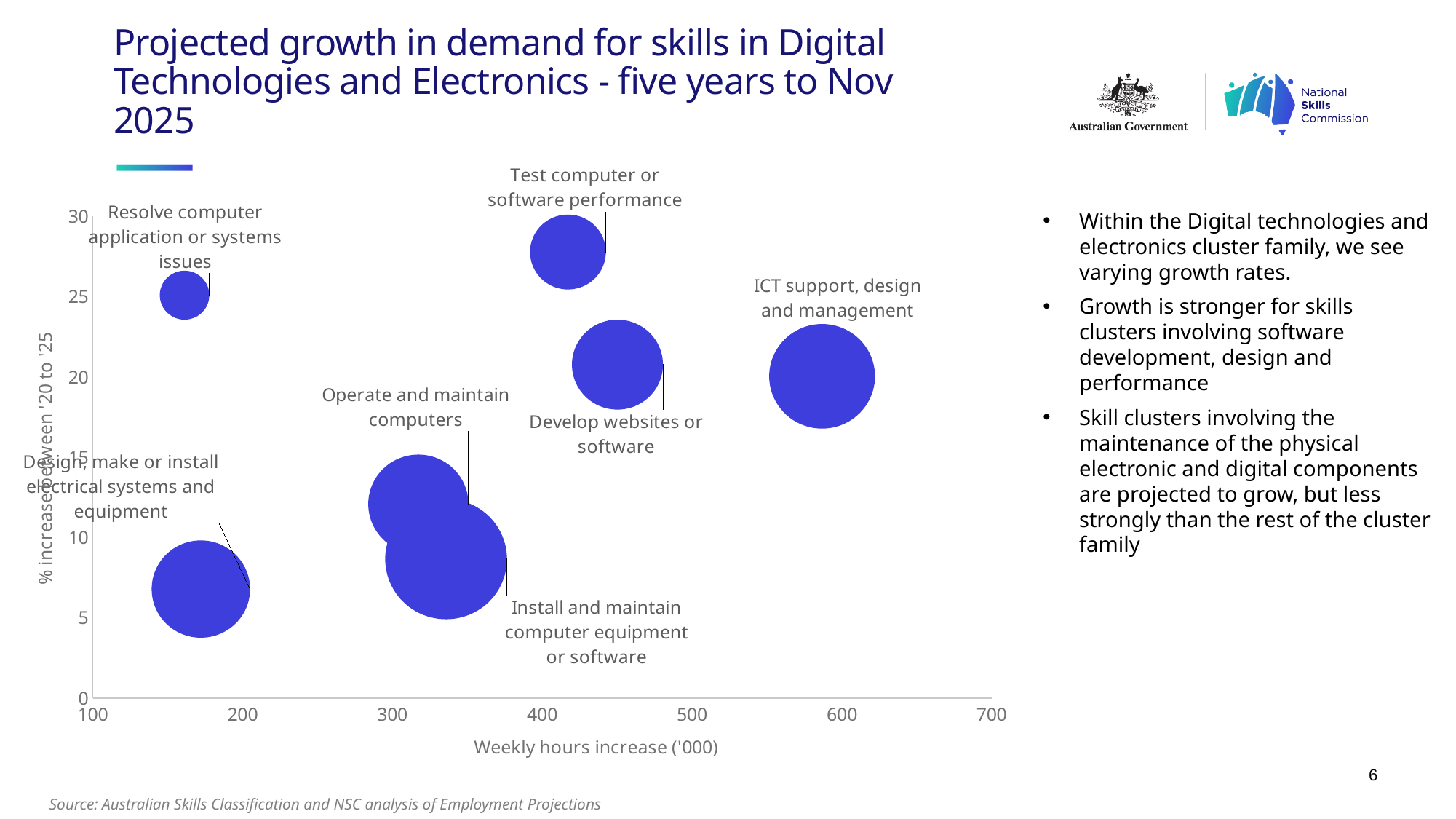
Is the weekly hours increase for Resolve computer application or systems issues greater or less than 200? less Which skill cluster has the largest weekly hours increase ('000)? ICT support, design and management Is the % increase for Develop websites or software greater or less than 15? greater What is the label of the x axis? Weekly hours increase ('000) How many skill clusters (bubbles) are plotted on the chart? 7 What kind of chart is shown on the slide? bubble chart Is the % increase for Design, make or install electrical systems and equipment greater or less than 10? less Which has a larger weekly hours increase: ICT support, design and management or Develop websites or software? ICT support, design and management Which has a higher % increase between '20 to '25: Test computer or software performance or Develop websites or software? Test computer or software performance Which skill cluster has the highest % increase between '20 to '25? Test computer or software performance